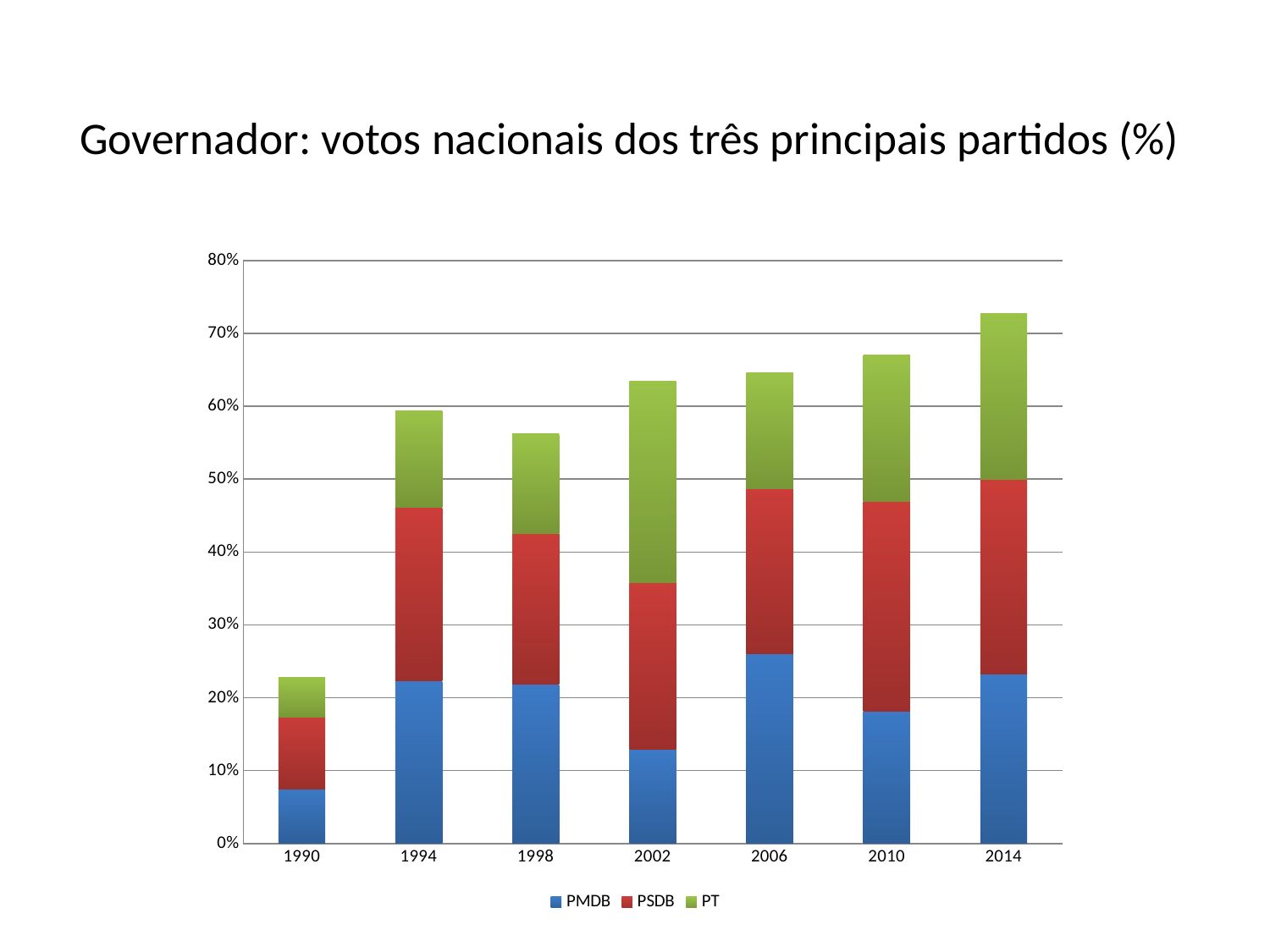
Is the combined total for 2014 greater or less than 70%? greater Is the PMDB value for 2002 greater or less than 20%? less Is the combined total for 1990 greater or less than 30%? less Which parties are listed in the legend? PMDB, PSDB, PT Does the combined total of the three parties rise or fall from 2002 to 2014? rise In which year is the combined total of the three parties highest? 2014 What kind of chart is shown on the slide? Stacked bar chart How many election years are shown on the x axis? 7 In which year is the combined total of the three parties lowest? 1990 Which year has the larger PMDB value, 2006 or 2010? 2006 What is the title of the chart? Governador: votos nacionais dos três principais partidos (%) How many series does the legend list? 3